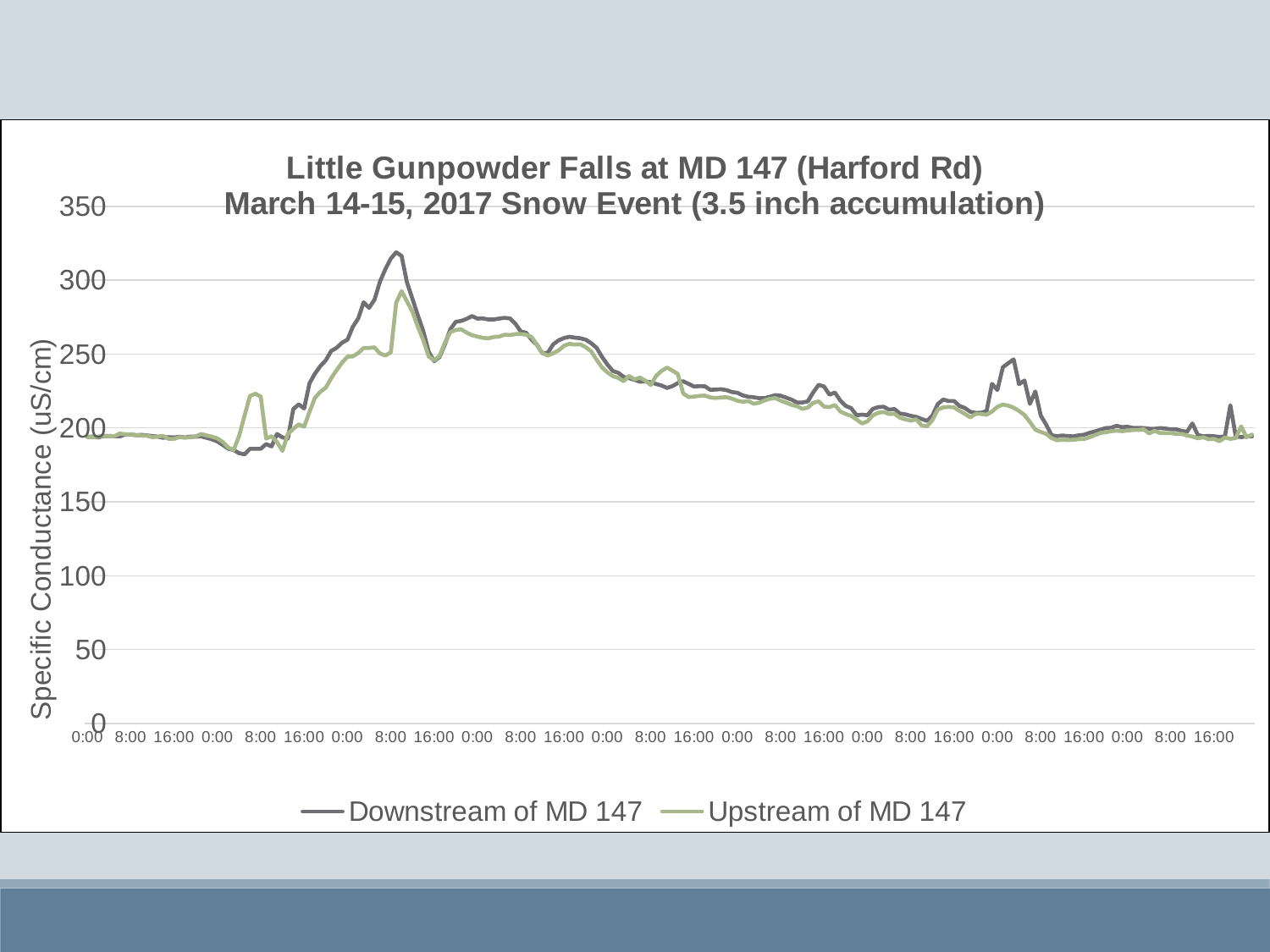
Is the peak value of the Upstream of MD 147 series greater or less than 250? greater Are the values of both series at the far left of the chart greater or less than 150? greater Is the peak value of the Upstream of MD 147 series greater or less than 300? less What kind of chart is shown on the slide? line chart What is the label on the vertical axis? Specific Conductance (uS/cm) Which series reaches the highest value on the chart? Downstream of MD 147 What are the two series named in the legend? Downstream of MD 147 and Upstream of MD 147 How many series does the legend list? 2 After the main peak, do the values generally rise or fall toward the right end of the x axis? fall At the highest peak of the chart, which series has the larger value, Downstream of MD 147 or Upstream of MD 147? Downstream of MD 147